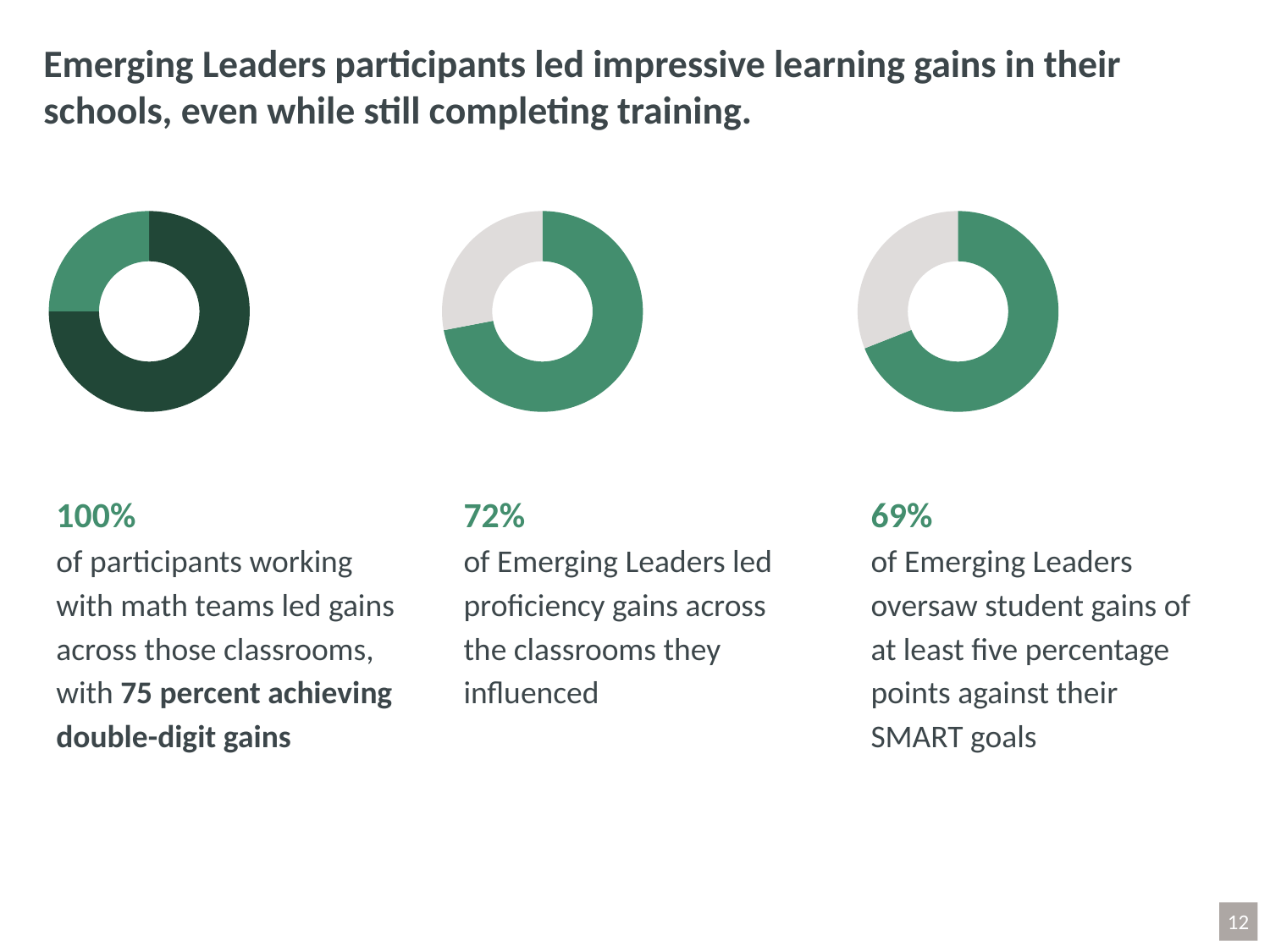
In the middle donut chart, what percentage of Emerging Leaders led proficiency gains across the classrooms they influenced? 72% What colour is used for the filled (highlighted) segment in the middle and right donut charts? Green In the left donut chart, what percentage of participants working with math teams led gains across those classrooms? 100% Which of the three donut charts shows the highest percentage? The left donut chart (100%) In the middle donut chart, what share of the ring is shown in grey (the portion not led by Emerging Leaders)? 28% In the right donut chart, what percentage of Emerging Leaders oversaw student gains of at least five percentage points against their SMART goals? 69% How many donut charts are shown on the slide? 3 What is the difference in percentage points between the middle donut chart value (72%) and the right donut chart value (69%)? 3 percentage points What kind of chart is used on this slide? Donut (pie) chart Which is larger: the percentage in the middle donut chart (proficiency gains) or the percentage in the right donut chart (SMART goal gains)? Middle donut chart (72%) According to the left donut chart's caption, what percent of participants working with math teams achieved double-digit gains? 75 percent Which of the three donut charts shows the lowest percentage? The right donut chart (69%)